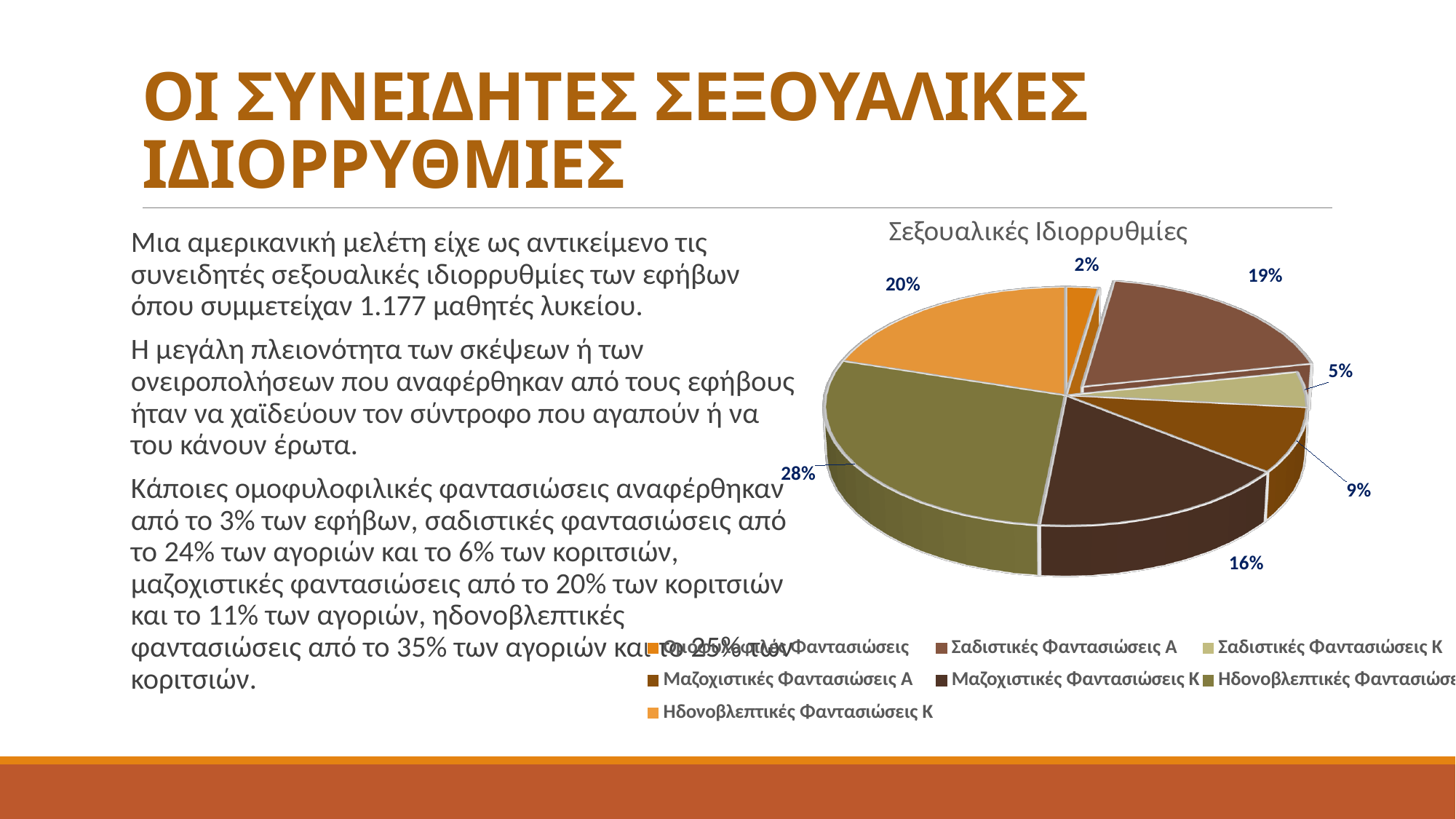
What is the smallest percentage labelled on the pie chart? 2% What is the title of the chart? Σεξουαλικές Ιδιορρυθμίες What is the largest percentage labelled on the pie chart? 28% What type of chart is shown on the slide? pie chart How many slices does the pie chart have? 7 Which is larger, the slice for Σαδιστικές Φαντασιώσεις Α or the slice for Μαζοχιστικές Φαντασιώσεις Κ? Σαδιστικές Φαντασιώσεις Α What percentage is shown for Σαδιστικές Φαντασιώσεις Α? 19% What percentage is shown for Ηδονοβλεπτικές Φαντασιώσεις Κ? 20% What percentage is shown for Μαζοχιστικές Φαντασιώσεις Α? 9% What percentage is shown for Σαδιστικές Φαντασιώσεις Κ? 5% What percentage is shown for Μαζοχιστικές Φαντασιώσεις Κ? 16% What is the difference in percentage points between Ηδονοβλεπτικές Φαντασιώσεις Κ and Μαζοχιστικές Φαντασιώσεις Α? 11